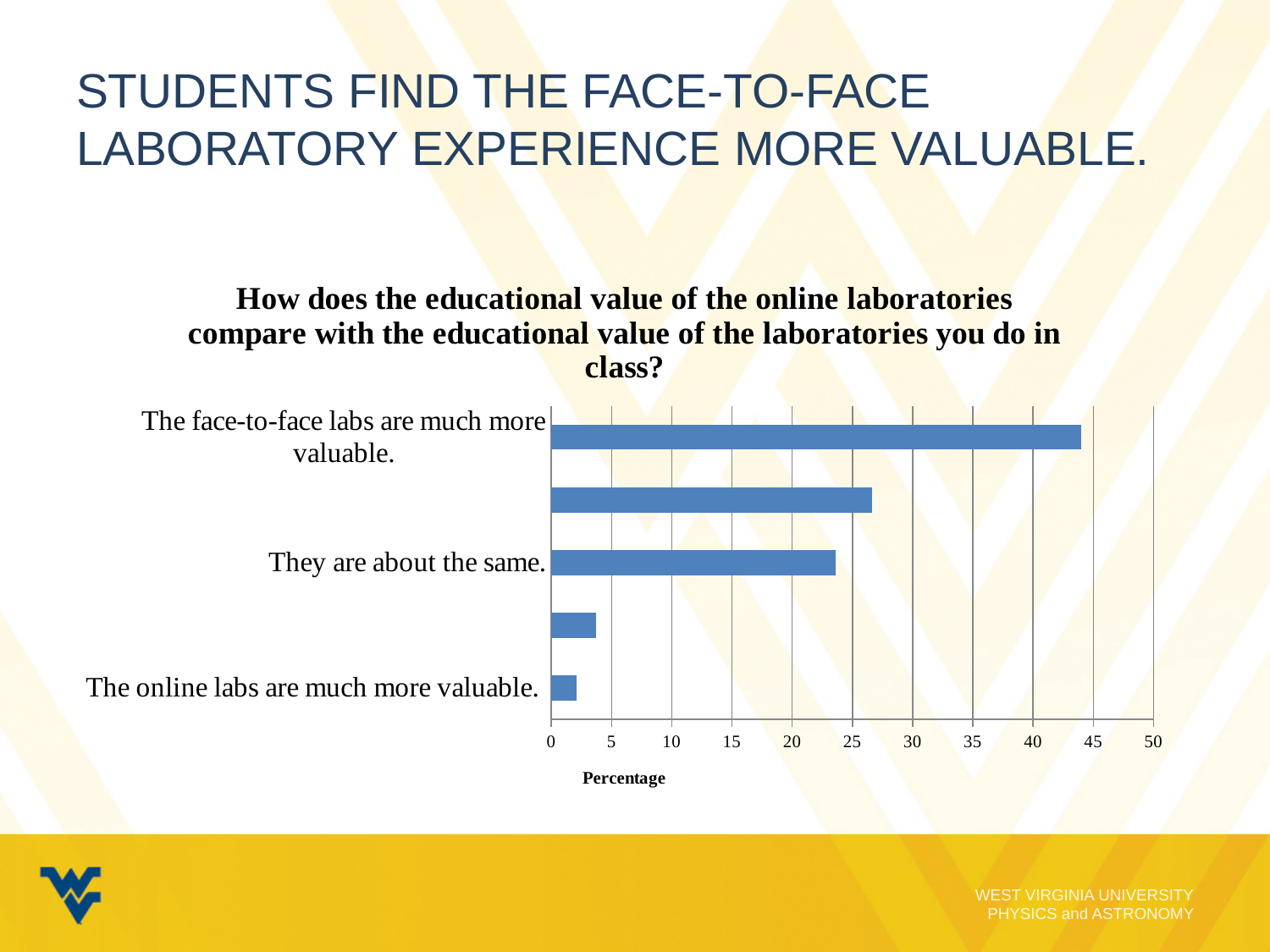
How many bars are plotted in the chart? 5 Which category has the lowest percentage? The online labs are much more valuable. Which is larger: the value for "The face-to-face labs are much more valuable." or the value for "They are about the same."? The face-to-face labs are much more valuable. What is the maximum value shown on the horizontal axis? 50 Is the value for "They are about the same." greater or less than 20? greater Is the value for "The face-to-face labs are much more valuable." greater or less than 40? greater Is the value for "The online labs are much more valuable." greater or less than 5? less What kind of chart is shown on the slide? bar chart Which category has the highest percentage? The face-to-face labs are much more valuable. What is the label of the horizontal axis? Percentage